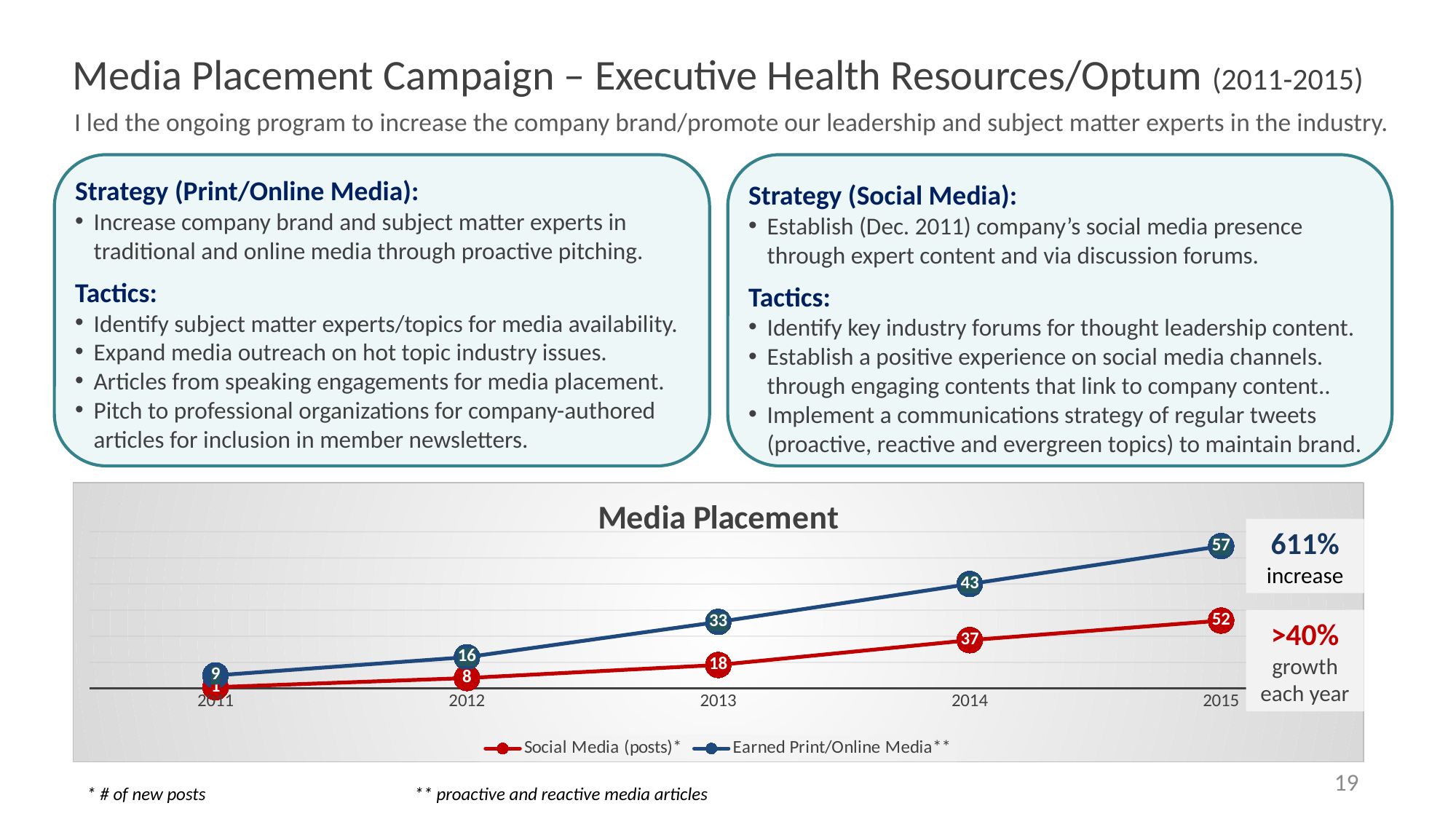
In which year is Social Media (posts) lowest? 2011 How many series does the legend of the Media Placement chart list? 2 What is the value for Social Media (posts) in 2012? 8 In which year is Earned Print/Online Media highest? 2015 How many years are plotted on the x axis of the Media Placement chart? 5 What is the value for Earned Print/Online Media in 2015? 57 What is the difference between Earned Print/Online Media and Social Media (posts) in 2013? 15 What type of chart is the Media Placement chart? line chart What is the value for Earned Print/Online Media in 2013? 33 Which series has the larger value in 2014, Social Media (posts) or Earned Print/Online Media? Earned Print/Online Media Do the Social Media (posts) values rise or fall from 2011 to 2015? rise What is the value for Social Media (posts) in 2014? 37